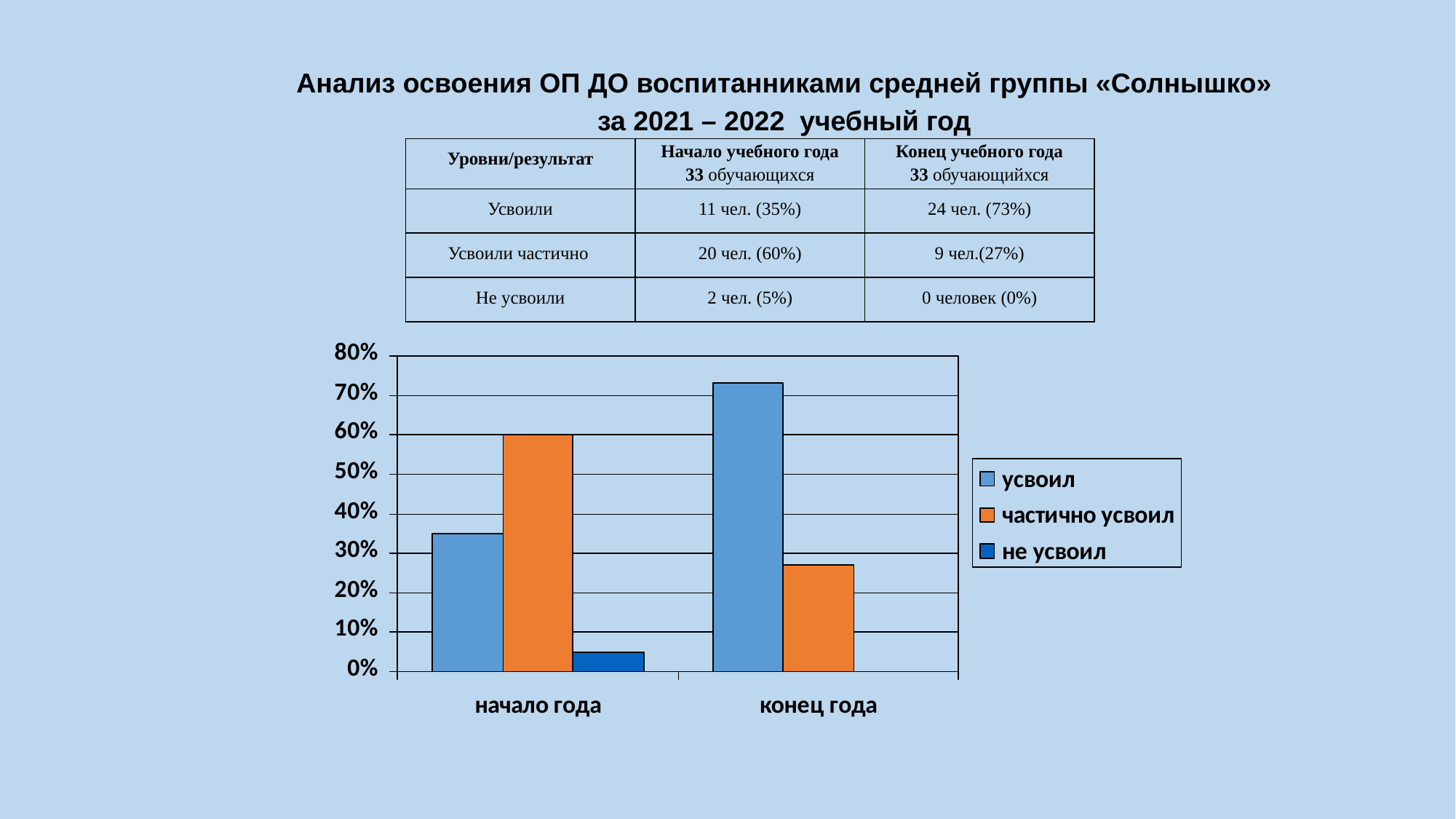
What is the difference between the 'усвоил' values for 'конец года' and 'начало года'? 38% How many categories are shown on the x axis of the chart? 2 Is the 'усвоил' bar for 'конец года' greater or less than 70%? greater How many series does the chart legend list? 3 Is the 'усвоил' bar for 'начало года' greater or less than 40%? less Which series has the lowest bar for 'начало года'? не усвоил What is the value of the 'частично усвоил' bar for 'начало года'? 60% What kind of chart is shown on the slide? bar chart What is the value of the 'не усвоил' bar for 'начало года'? 5% What is the value of the 'усвоил' bar for 'конец года'? 73% Which series has the highest bar for 'конец года'? усвоил Which is larger: the 'частично усвоил' bar for 'начало года' or for 'конец года'? начало года